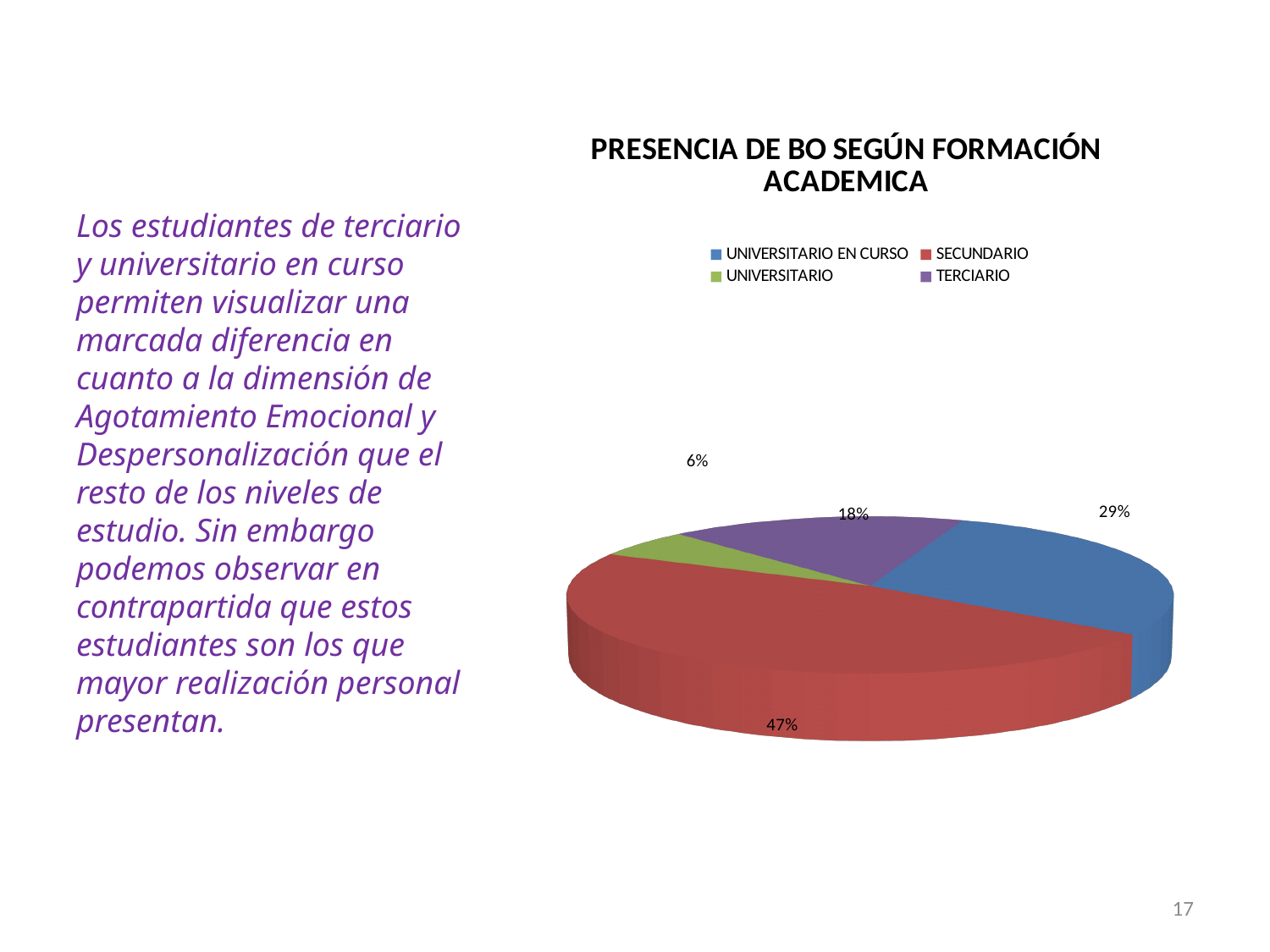
Which category has the smallest slice of the pie? UNIVERSITARIO What is the value shown for UNIVERSITARIO EN CURSO? 29% What kind of chart is shown on the slide? Pie chart Which colour represents SECUNDARIO in the chart? Red Which is larger, the share for TERCIARIO or the share for UNIVERSITARIO? TERCIARIO What is the title of the chart? PRESENCIA DE BO SEGÚN FORMACIÓN ACADEMICA How many categories are shown in the pie chart? 4 What is the value shown for UNIVERSITARIO? 6% Which category has the largest slice of the pie? SECUNDARIO What share of the pie does SECUNDARIO represent? 47% What is the value shown for TERCIARIO? 18% What is the difference between the SECUNDARIO and UNIVERSITARIO EN CURSO shares? 18%